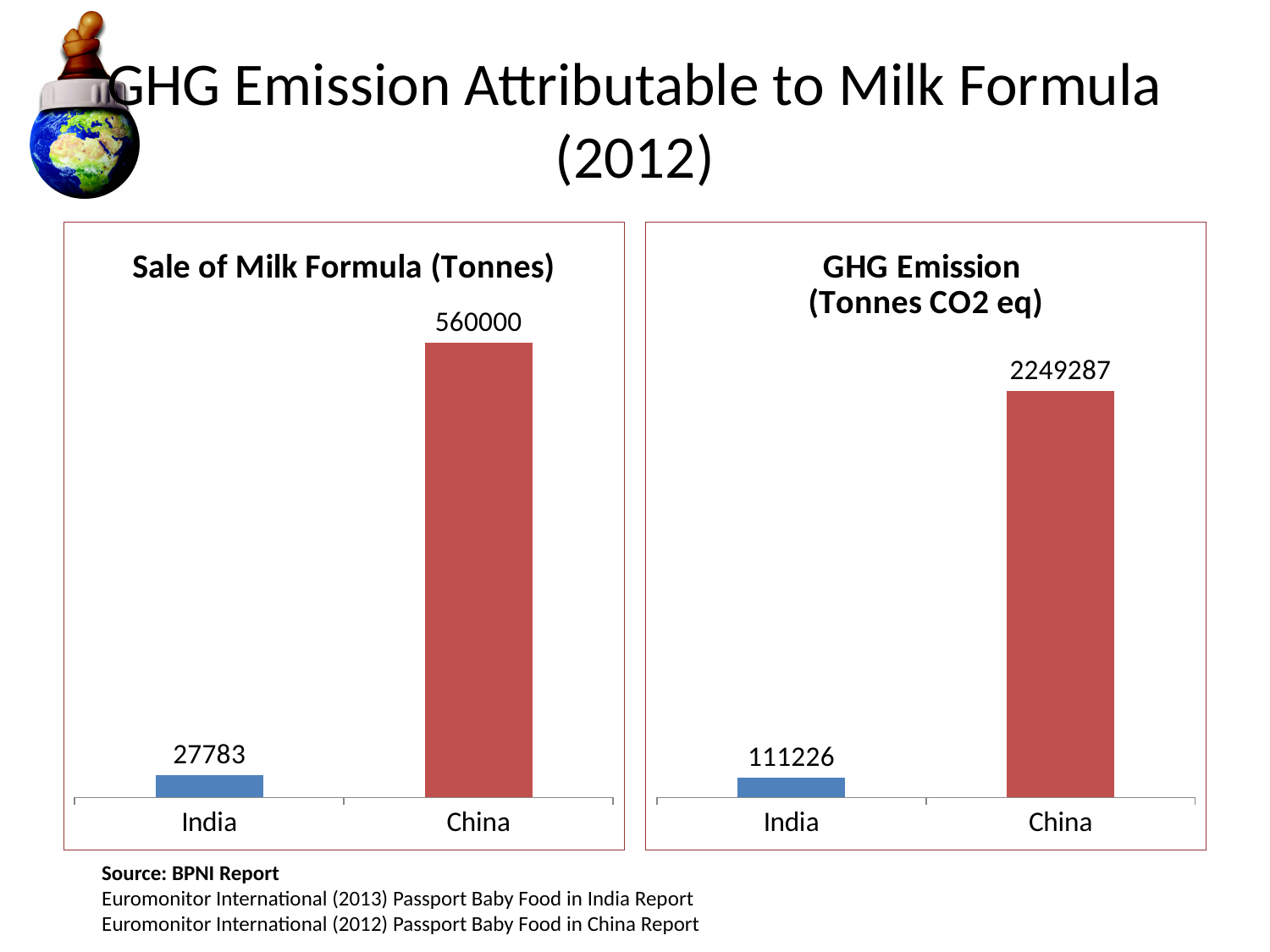
How many countries are shown in the 'Sale of Milk Formula (Tonnes)' chart? 2 In the 'Sale of Milk Formula (Tonnes)' chart, what is the difference between China's and India's values? 532217 In the 'GHG Emission (Tonnes CO2 eq)' chart, what is the value for India? 111226 In the 'GHG Emission (Tonnes CO2 eq)' chart, what is the difference between China's and India's values? 2138061 What is the title of the chart on the left side of the slide? Sale of Milk Formula (Tonnes) What type of chart is the 'GHG Emission (Tonnes CO2 eq)' chart? bar chart In the 'GHG Emission (Tonnes CO2 eq)' chart, which country has the lowest value? India In the 'GHG Emission (Tonnes CO2 eq)' chart, what is the value for China? 2249287 In the 'Sale of Milk Formula (Tonnes)' chart, what is the value for India? 27783 In the 'Sale of Milk Formula (Tonnes)' chart, which country has the higher value? China In the 'GHG Emission (Tonnes CO2 eq)' chart, is the value for India larger or smaller than the value for China? smaller In the 'Sale of Milk Formula (Tonnes)' chart, what is the value for China? 560000